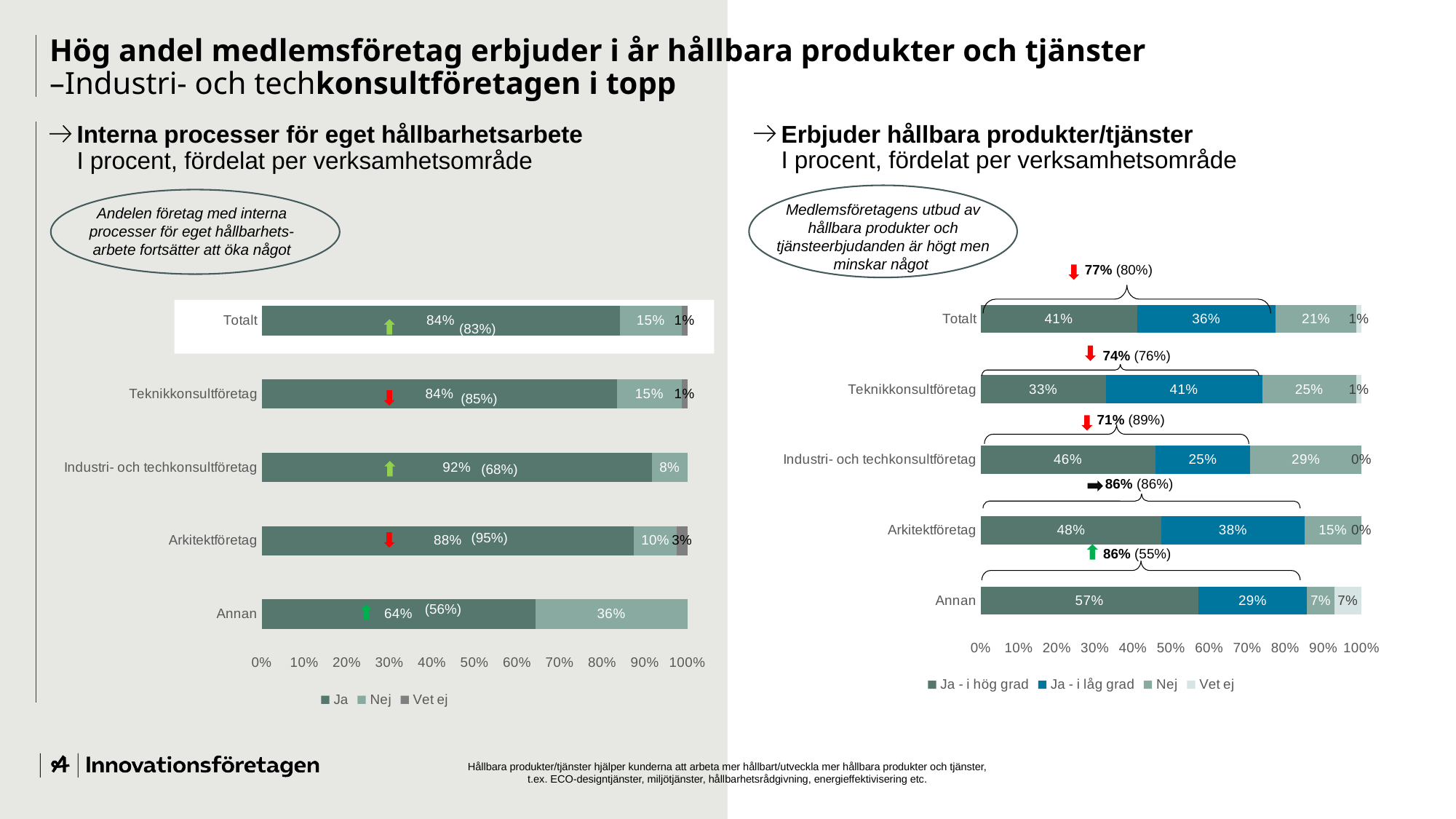
In the left chart 'Interna processer för eget hållbarhetsarbete', what is the 'Ja' value for Industri- och techkonsultföretag? 92% What type of chart is the right chart 'Erbjuder hållbara produkter/tjänster'? Stacked bar chart In the right chart 'Erbjuder hållbara produkter/tjänster', what is the 'Ja - i hög grad' value for Annan? 57% In the left chart 'Interna processer för eget hållbarhetsarbete', which category has the lowest 'Ja' value? Annan In the right chart 'Erbjuder hållbara produkter/tjänster', which category has the highest 'Ja - i låg grad' value? Teknikkonsultföretag In the left chart 'Interna processer för eget hållbarhetsarbete', what is the 'Nej' value for Annan? 36% How many series does the legend of the left chart 'Interna processer för eget hållbarhetsarbete' list? 3 In the right chart 'Erbjuder hållbara produkter/tjänster', is the 'Ja - i hög grad' value for Teknikkonsultföretag larger or smaller than that for Arkitektföretag? smaller In the right chart 'Erbjuder hållbara produkter/tjänster', what is the 'Nej' value for Industri- och techkonsultföretag? 29% In the left chart 'Interna processer för eget hållbarhetsarbete', what is the difference between the 'Ja' values for Arkitektföretag and Annan? 24 percentage points In the left chart 'Interna processer för eget hållbarhetsarbete', which category has the highest 'Ja' value? Industri- och techkonsultföretag How many series does the legend of the right chart 'Erbjuder hållbara produkter/tjänster' list? 4